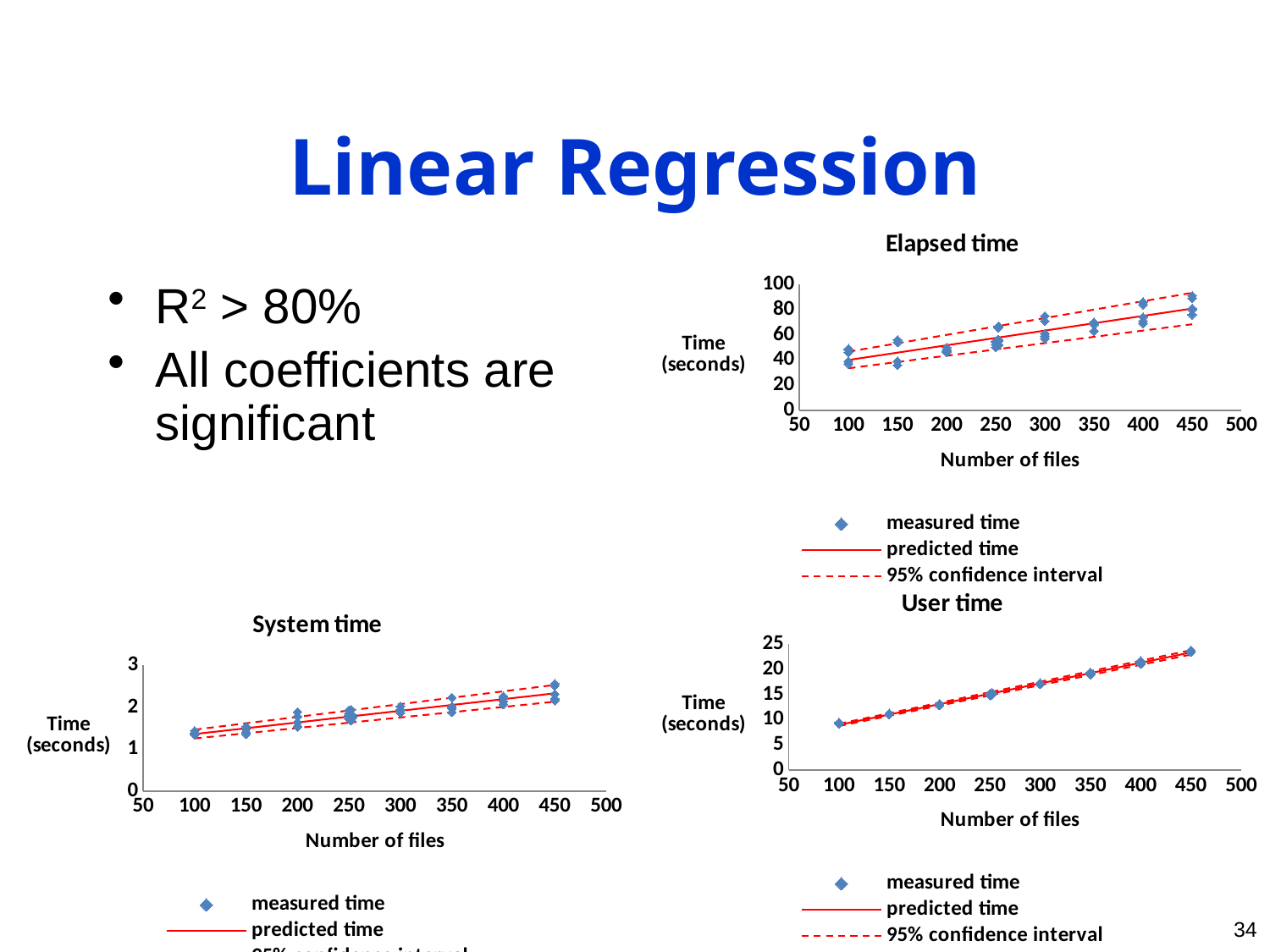
In the User time chart, is the predicted time at 450 files greater or less than 20 seconds? greater In the User time chart, does the predicted time rise or fall along the x axis? rise What is the x-axis title of the System time chart? Number of files In the Elapsed time chart, does the measured time rise or fall as the number of files increases? rise In the User time chart, what does the dashed red line represent according to the legend? 95% confidence interval In the Elapsed time chart, what kind of chart is used to show the measured time? scatter chart In the Elapsed time chart, is the predicted time at 450 files greater or less than 60 seconds? greater In the System time chart, is the predicted time at 100 files greater or less than 2 seconds? less How many series does the legend of the Elapsed time chart list? 3